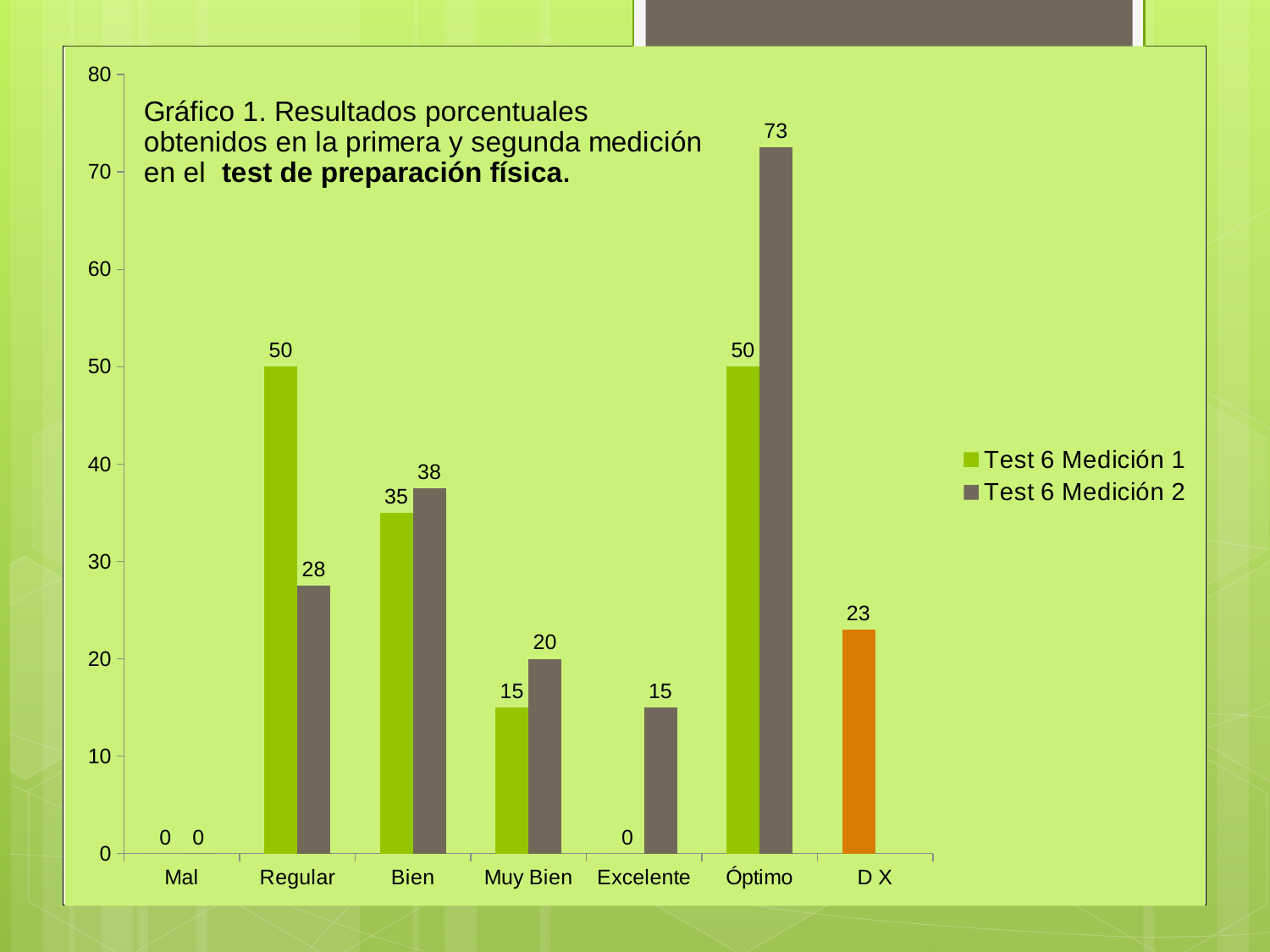
What is the value for Test 6 Medición 2 in the Óptimo category? 73 How many categories are shown on the x axis? 7 What is the difference between Test 6 Medición 1 and Test 6 Medición 2 in the Muy Bien category? 5 What type of chart is shown on the slide? bar chart What is the value for Test 6 Medición 2 in the Excelente category? 15 What is the value of the bar in the D X category? 23 Which is larger in the Regular category, Test 6 Medición 1 or Test 6 Medición 2? Test 6 Medición 1 Which category has the highest value for Test 6 Medición 2? Óptimo How many series does the legend list? 2 What is the value for Test 6 Medición 1 in the Regular category? 50 What is the difference between Test 6 Medición 2 and Test 6 Medición 1 in the Óptimo category? 23 What is the value for Test 6 Medición 1 in the Bien category? 35